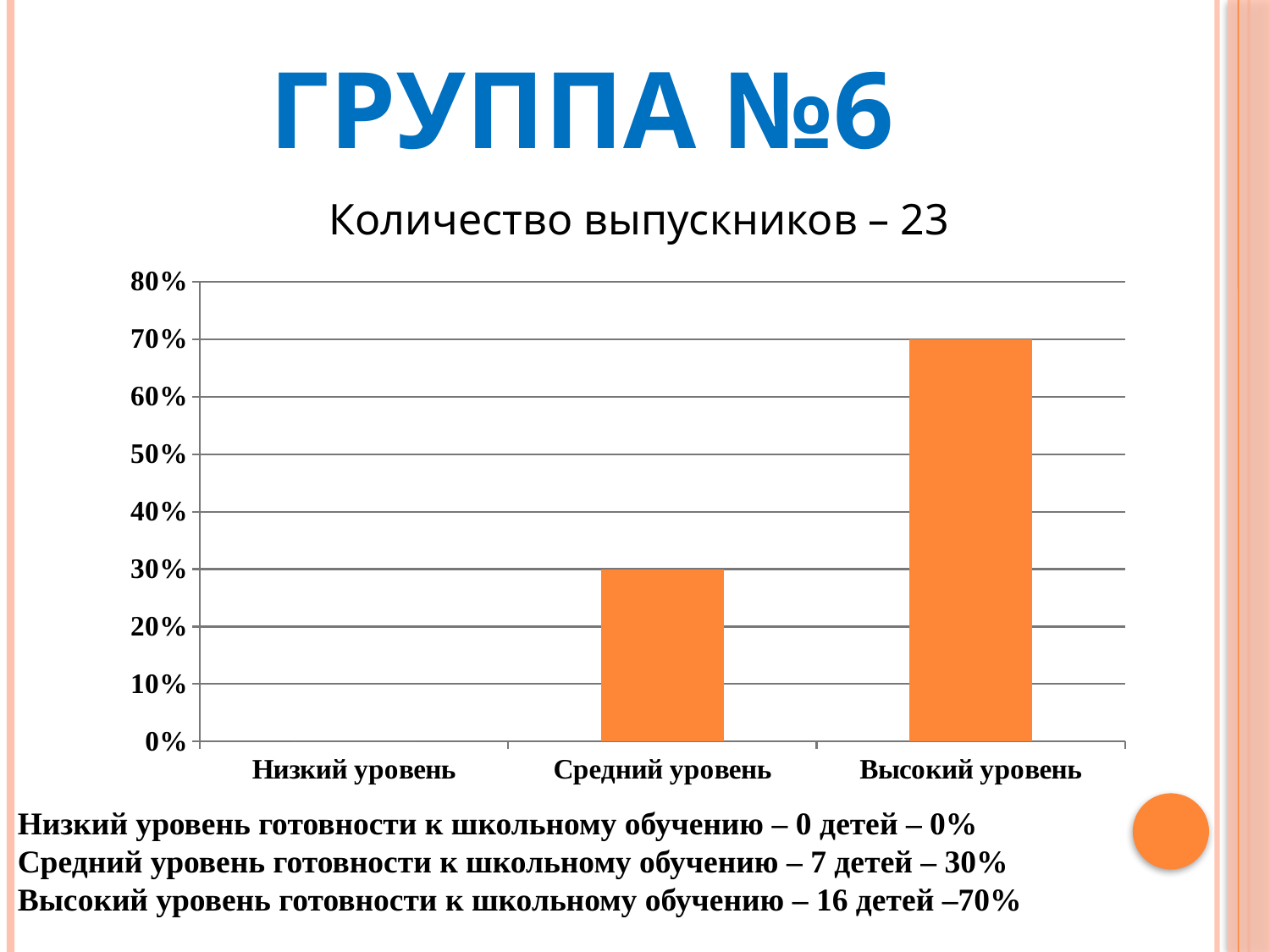
What is the value for Высокий уровень? 70% What kind of chart is shown on the slide? bar chart Is the value for Высокий уровень greater or less than 60%? greater Which category has the lowest value? Низкий уровень Which is larger, the value for Средний уровень or the value for Высокий уровень? Высокий уровень Which category has the highest value? Высокий уровень Do the values rise or fall from left to right along the x axis? rise Is the value for Средний уровень greater or less than 40%? less What is the value for Средний уровень? 30% How many categories are shown on the x axis? 3 What is the value for Низкий уровень? 0% What is the difference between the values for Высокий уровень and Средний уровень? 40%